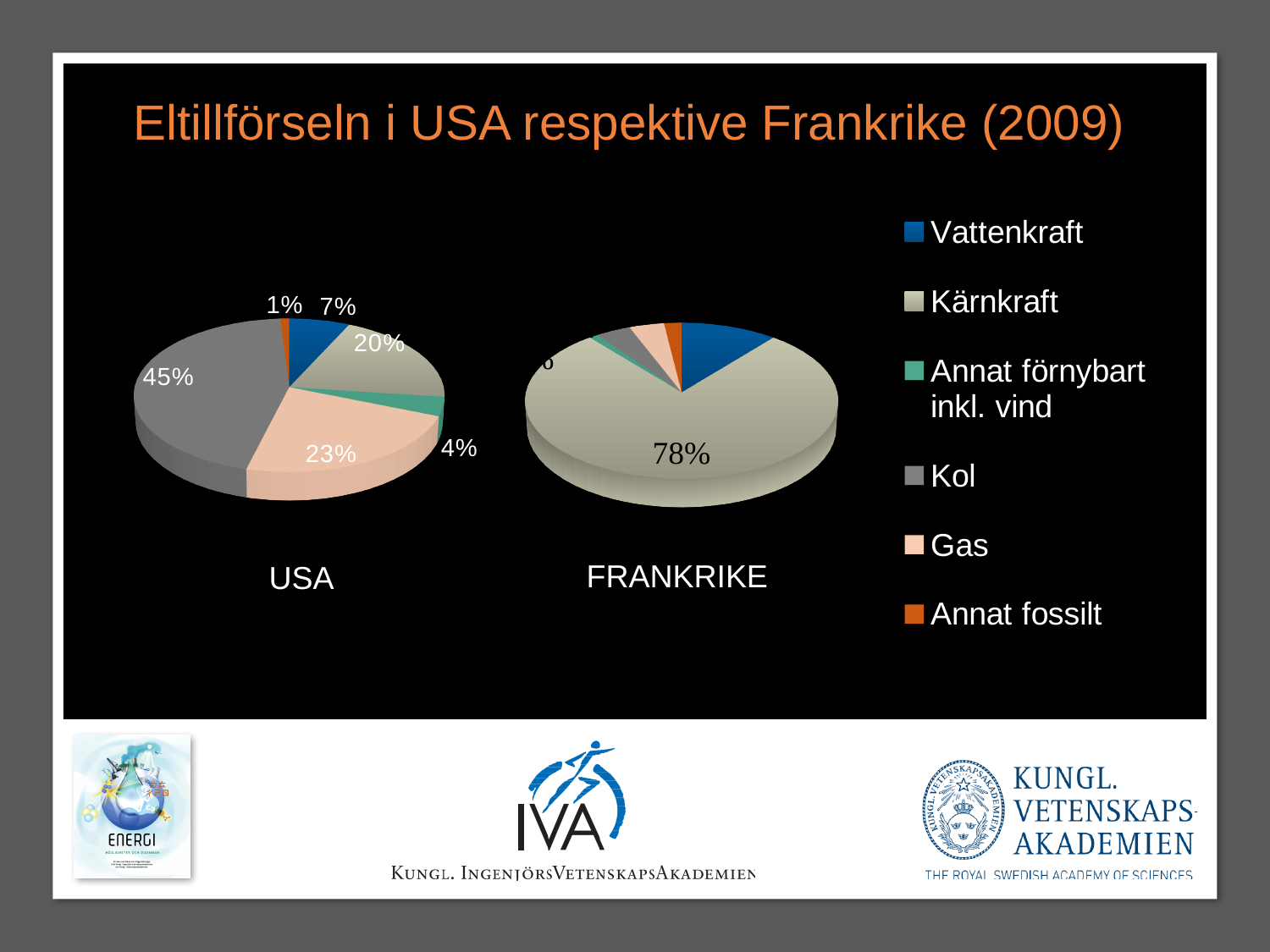
On the USA pie chart, which is larger, Kärnkraft or Vattenkraft? Kärnkraft On the USA pie chart, which category has the smallest share? Annat fossilt On the USA pie chart, what share is Vattenkraft? 7% On the USA pie chart, what share is Kärnkraft? 20% On the USA pie chart, what share is Annat fossilt? 1% How many categories does the legend list? 6 On the USA pie chart, what is the difference between the Kol share and the Gas share? 22% On the FRANKRIKE pie chart, which category has the largest share? Kärnkraft On the USA pie chart, what share is Kol? 45% On the USA pie chart, which category has the largest share? Kol On the FRANKRIKE pie chart, what share is Kärnkraft? 78% On the USA pie chart, what share is Gas? 23%